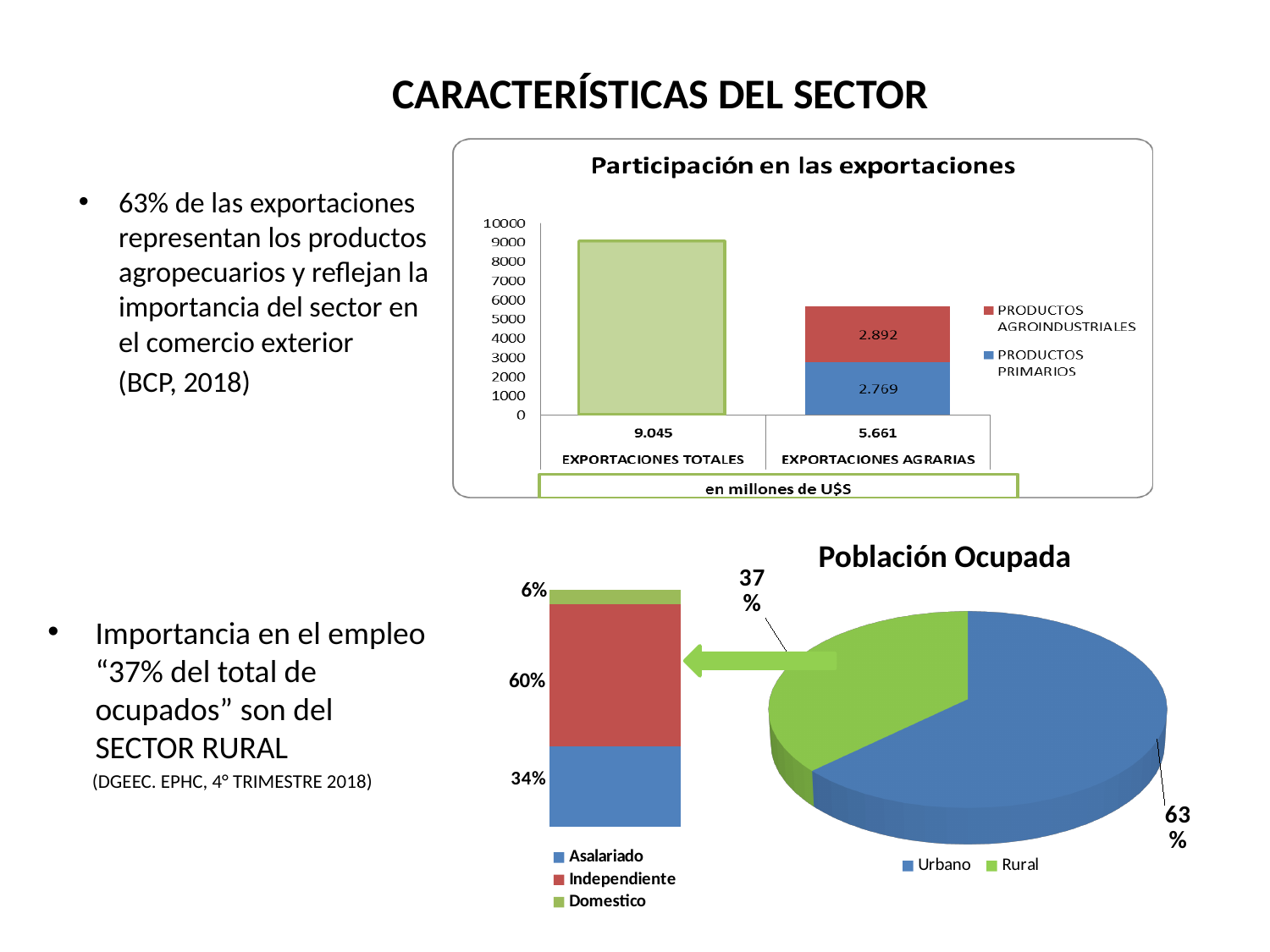
In the 'Participación en las exportaciones' chart, what is the difference between EXPORTACIONES TOTALES and EXPORTACIONES AGRARIAS? 3.384 What kind of chart is 'Población Ocupada'? Pie chart In the 'Participación en las exportaciones' chart, what is the value of PRODUCTOS AGROINDUSTRIALES within EXPORTACIONES AGRARIAS? 2.892 In the 'Participación en las exportaciones' chart, how many series does the legend list? 2 In the 'Población Ocupada' pie chart, which slice is larger, Urbano or Rural? Urbano In the 'Participación en las exportaciones' chart, what is the value for EXPORTACIONES AGRARIAS? 5.661 In the 'Participación en las exportaciones' chart, what unit is stated below the category axis? en millones de U$S In the 'Participación en las exportaciones' chart, what is the value of PRODUCTOS PRIMARIOS within EXPORTACIONES AGRARIAS? 2.769 In the 'Participación en las exportaciones' chart, what is the value for EXPORTACIONES TOTALES? 9.045 In the stacked bar chart at the bottom of the slide, which category has the lowest value? Domestico In the 'Población Ocupada' pie chart, what share is Rural? 37% In the stacked bar chart at the bottom of the slide, what is the value for Independiente? 60%